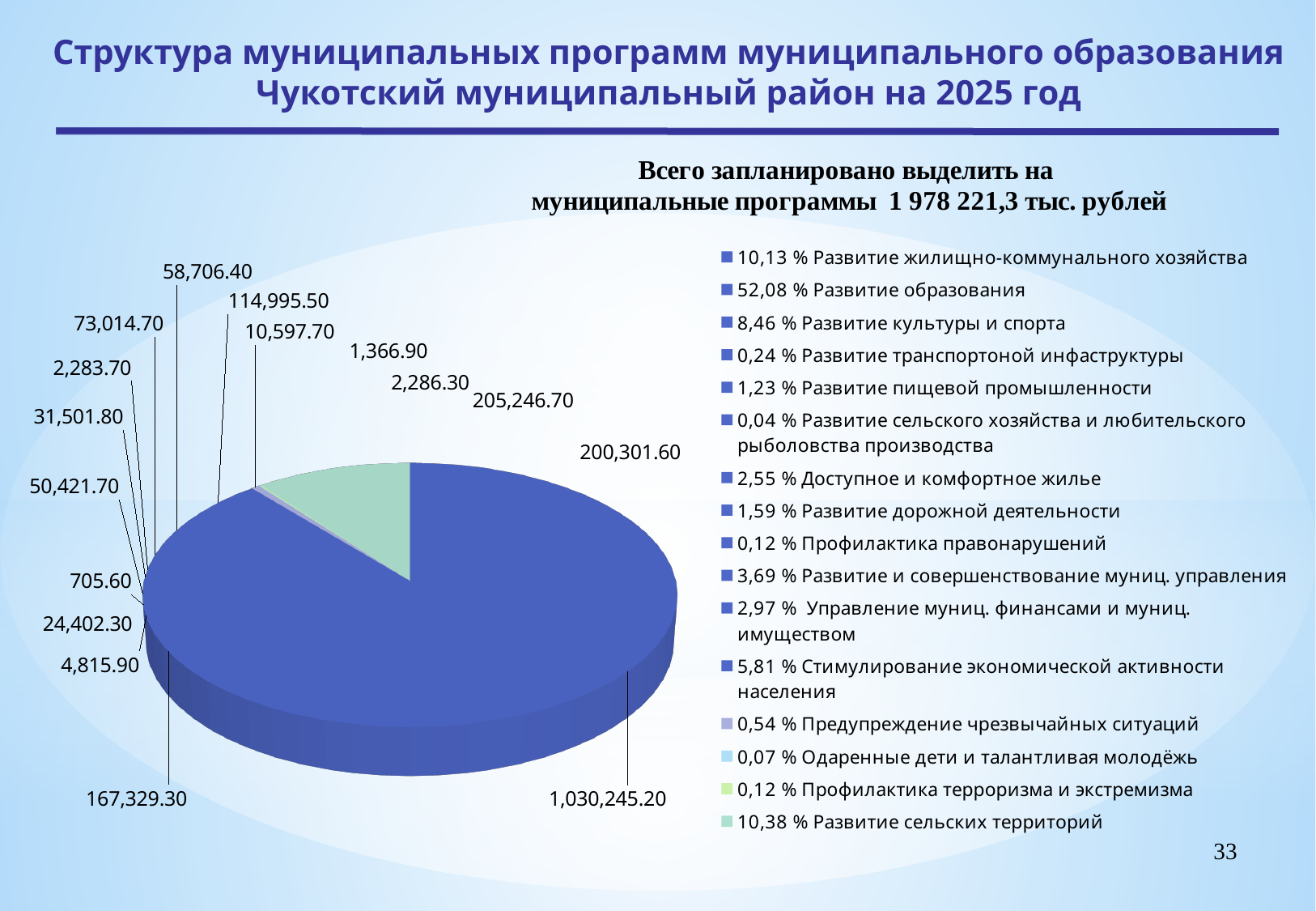
What value is labelled on the light green slice of the pie chart (Развитие сельских территорий)? 205,246.70 Which has the larger share in the legend: "Развитие сельских территорий" or "Развитие жилищно-коммунального хозяйства"? Развитие сельских территорий What total amount is planned for municipal programmes according to the text above the chart? 1 978 221,3 тыс. рублей What kind of chart is shown on the slide? pie chart What is the difference between the labelled values 1,030,245.20 and 205,246.70 on the pie chart? 824,998.50 According to the legend, what share of the pie does "Развитие образования" have? 52,08 % What is the largest value labelled on the pie chart? 1,030,245.20 How many entries does the legend of the pie chart list? 16 According to the legend, what share of the pie does "Стимулирование экономической активности населения" have? 5,81 % What colour is the slice for "Развитие сельских территорий" in the pie chart? light green What is the smallest value labelled on the pie chart? 705.60 According to the legend, what share of the pie does "Развитие сельских территорий" have? 10,38 %